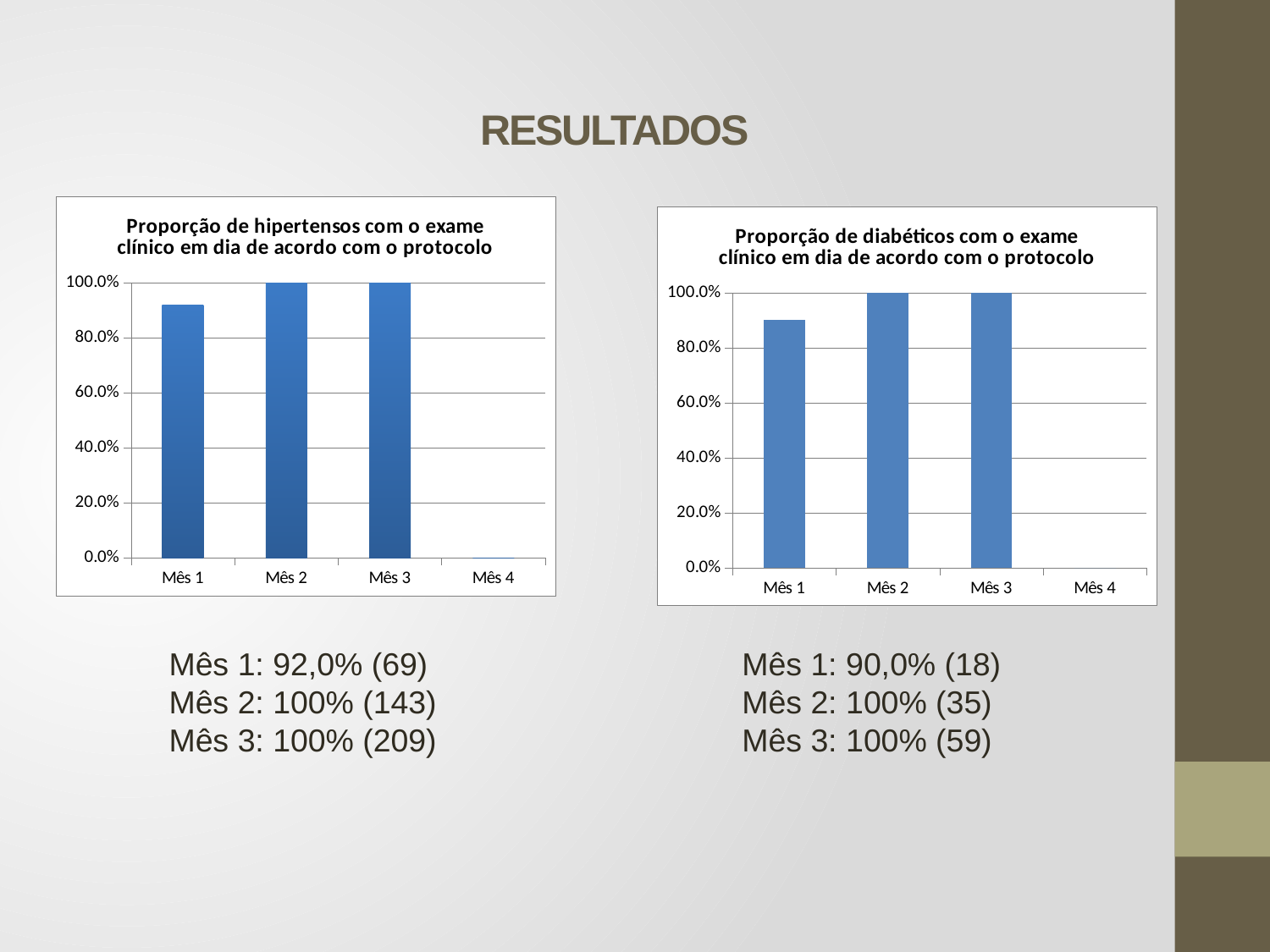
In the left chart (hipertensos), which month has the lowest value among the plotted bars? Mês 1 In the right chart (diabéticos), which month has the lowest value among the plotted bars? Mês 1 In the right chart (diabéticos), what is the value for Mês 3? 100% In the left chart (hipertensos), what is the value for Mês 1 according to the text below the chart? 92,0% What kind of chart is the left chart, 'Proporção de hipertensos com o exame clínico em dia de acordo com o protocolo'? bar chart How many month categories are shown on the x axis of the left chart (hipertensos)? 4 In the left chart (hipertensos), what is the value for Mês 2? 100% In the left chart (hipertensos), what is the difference between the value for Mês 2 and the value for Mês 1? 8,0% In the left chart (hipertensos), is the value for Mês 1 greater or less than 80.0%? greater In the right chart (diabéticos), which is larger, the value for Mês 1 or the value for Mês 2? Mês 2 In the right chart (diabéticos), what is the value for Mês 1 according to the text below the chart? 90,0% In the right chart (diabéticos), is the value for Mês 1 greater or less than 100.0%? less